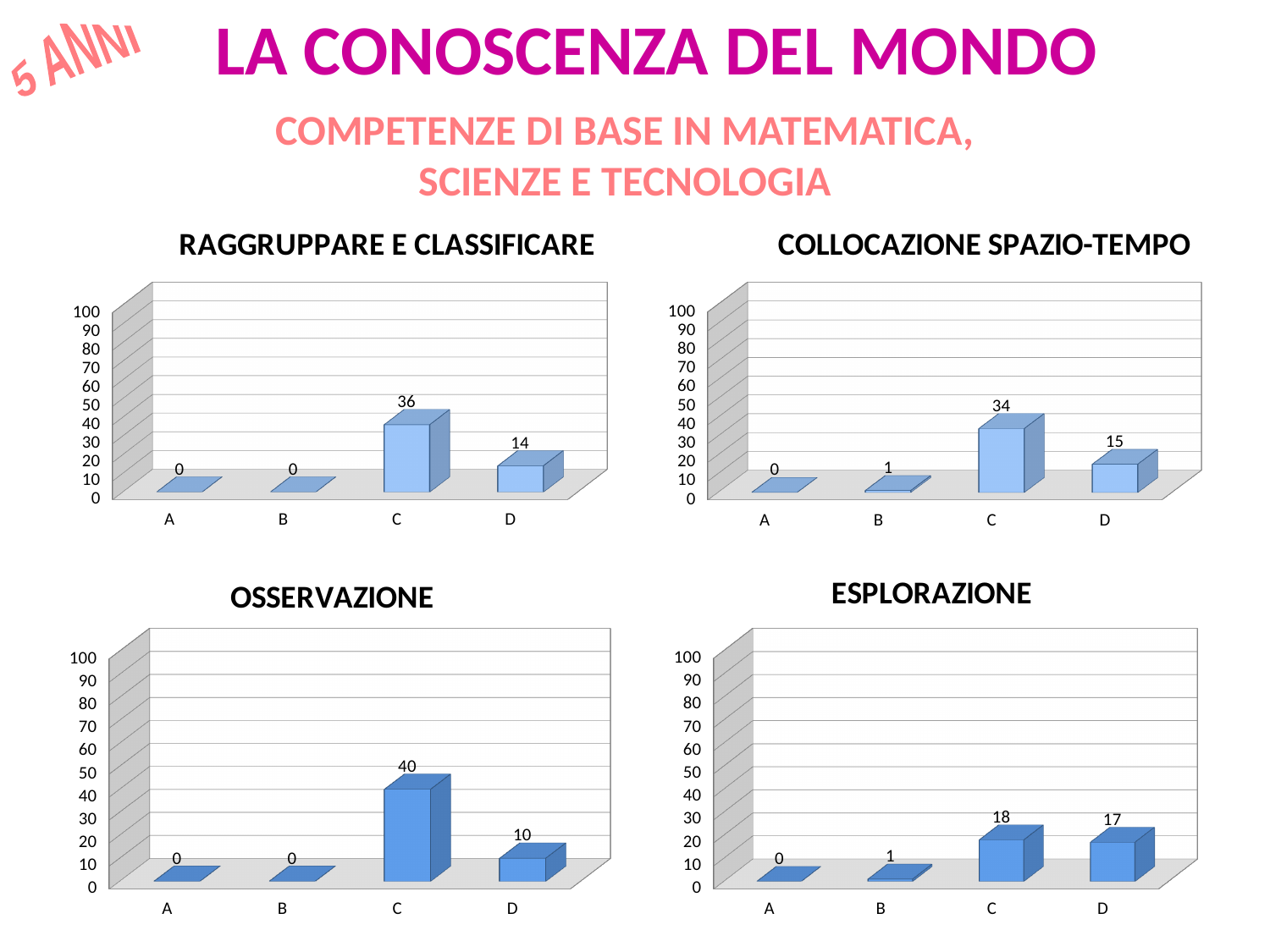
In the ESPLORAZIONE chart, is the value for C greater or less than 10? greater In the COLLOCAZIONE SPAZIO-TEMPO chart, what is the difference between the values for C and D? 19 In the RAGGRUPPARE E CLASSIFICARE chart, what is the value for C? 36 In the COLLOCAZIONE SPAZIO-TEMPO chart, what is the value for B? 1 In the RAGGRUPPARE E CLASSIFICARE chart, what is the value for D? 14 How many charts are shown on the slide? 4 In the ESPLORAZIONE chart, what is the value for D? 17 In the OSSERVAZIONE chart, what is the difference between the values for C and D? 30 In the OSSERVAZIONE chart, what is the value for C? 40 How many categories are shown on the x axis of the ESPLORAZIONE chart? 4 In the COLLOCAZIONE SPAZIO-TEMPO chart, which category has the highest value? C What kind of chart is the OSSERVAZIONE chart? bar chart